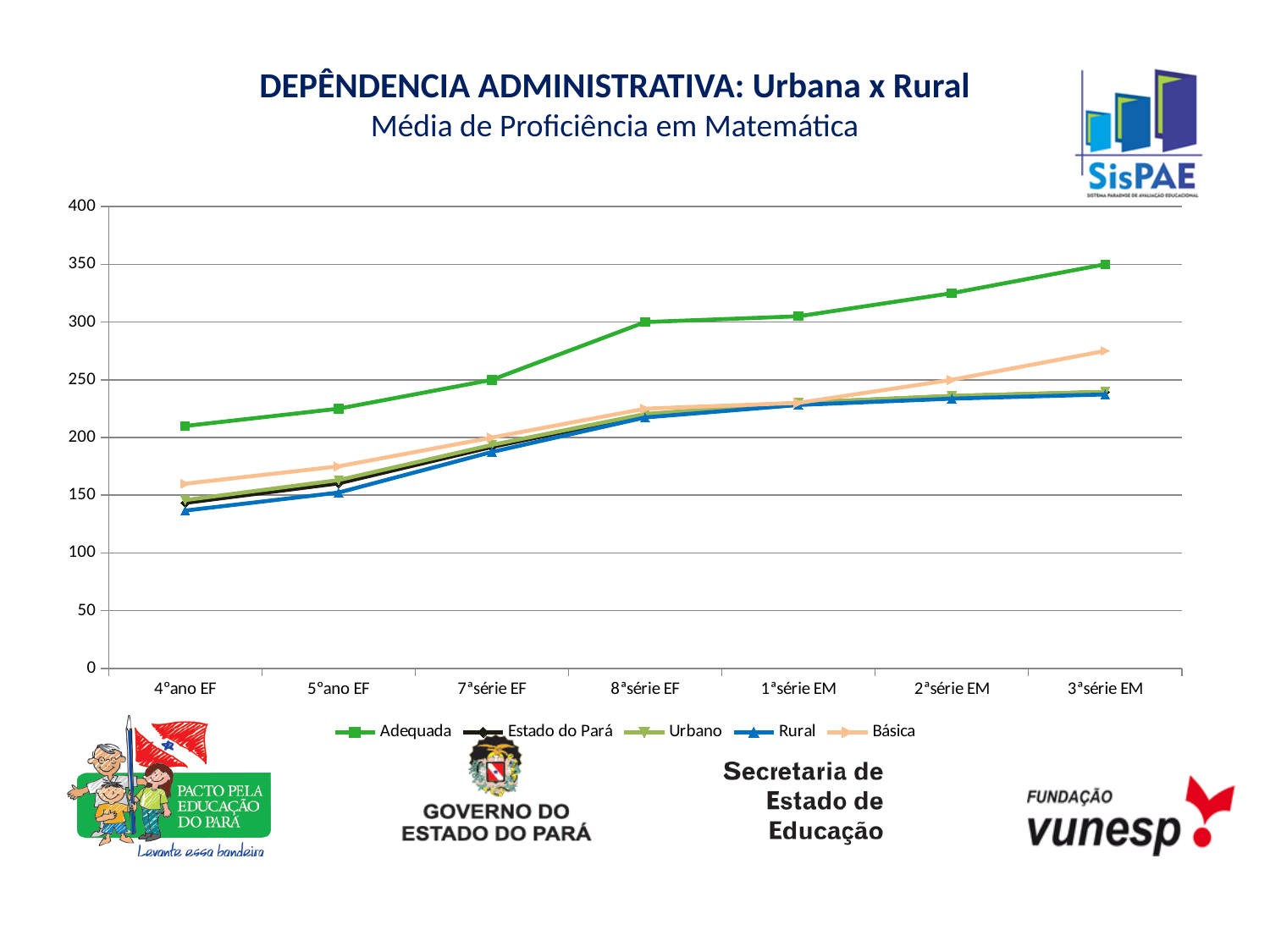
Does the Adequada series rise or fall from 4°ano EF to 3ªsérie EM? rise Is the value for Básica at 3ªsérie EM greater or less than 250? greater How many series does the legend list? 5 Is the value for Rural at 4°ano EF greater or less than 150? less What is the value of the Adequada series at 3ªsérie EM? 350 What is the value of the Adequada series at 7ªsérie EF? 250 How many categories are shown on the x axis? 7 Which series has the lowest value at 4°ano EF? Rural What is the value of the Adequada series at 8ªsérie EF? 300 What is the difference between the Adequada values at 3ªsérie EM and 8ªsérie EF? 50 What kind of chart is shown on the slide? line chart Which series has the highest value at 3ªsérie EM? Adequada